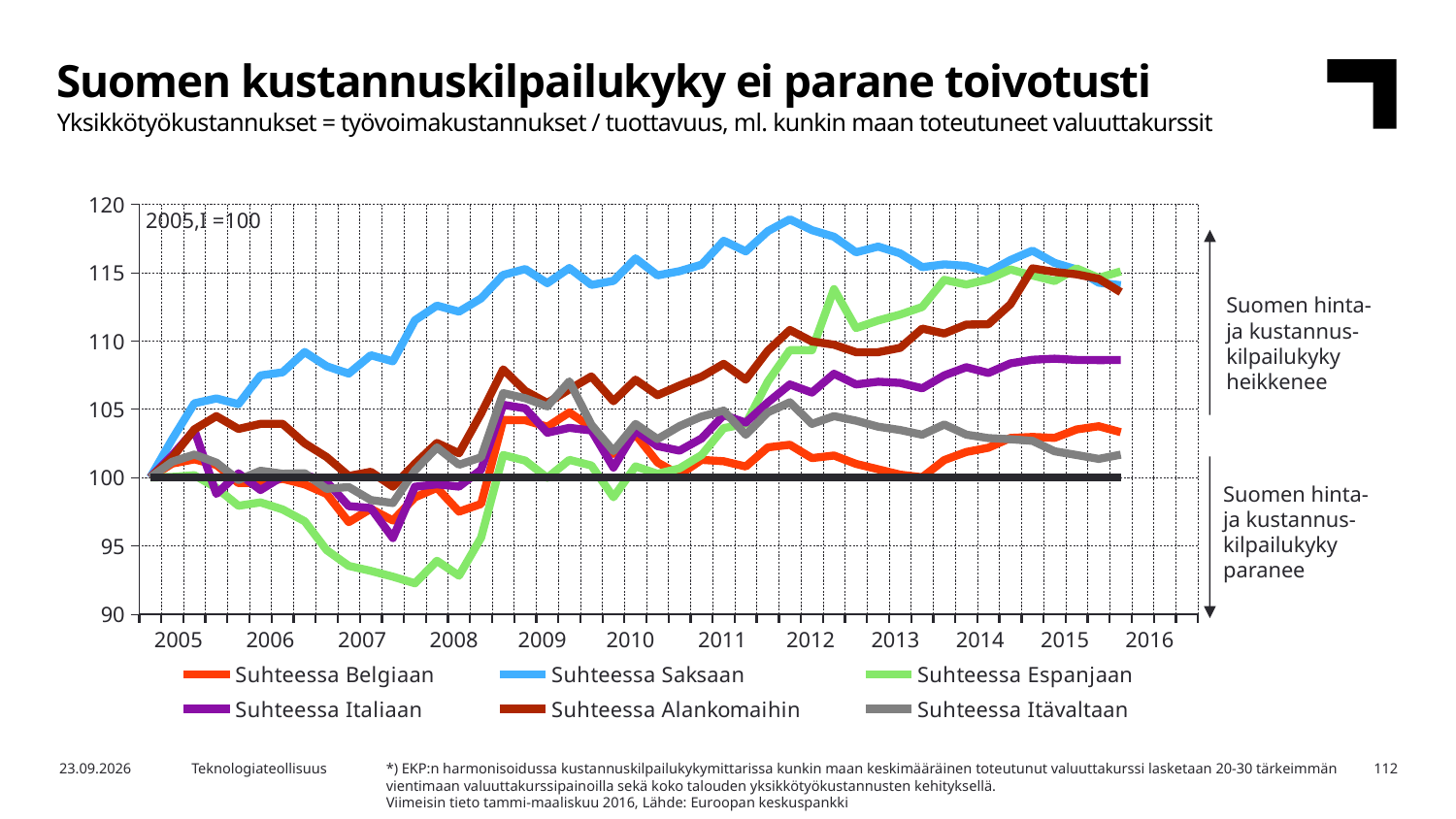
Is the value for Suhteessa Belgiaan in 2013 greater or less than 105? less How many series does the legend list? 6 What type of chart is shown on the slide? line chart Which series has the lowest value in 2007? Suhteessa Espanjaan What colour is the line for Suhteessa Saksaan? blue Is the value for Suhteessa Espanjaan in 2007 greater or less than 95? less Does the Suhteessa Saksaan line rise or fall from 2005 to 2012? rise Which series has the highest value in 2012? Suhteessa Saksaan In 2010, which is larger: the value for Suhteessa Saksaan or the value for Suhteessa Belgiaan? Suhteessa Saksaan Is the value for Suhteessa Italiaan in 2015 greater or less than 105? greater What base period and value is the index set to, as noted in the chart? 2005,I = 100